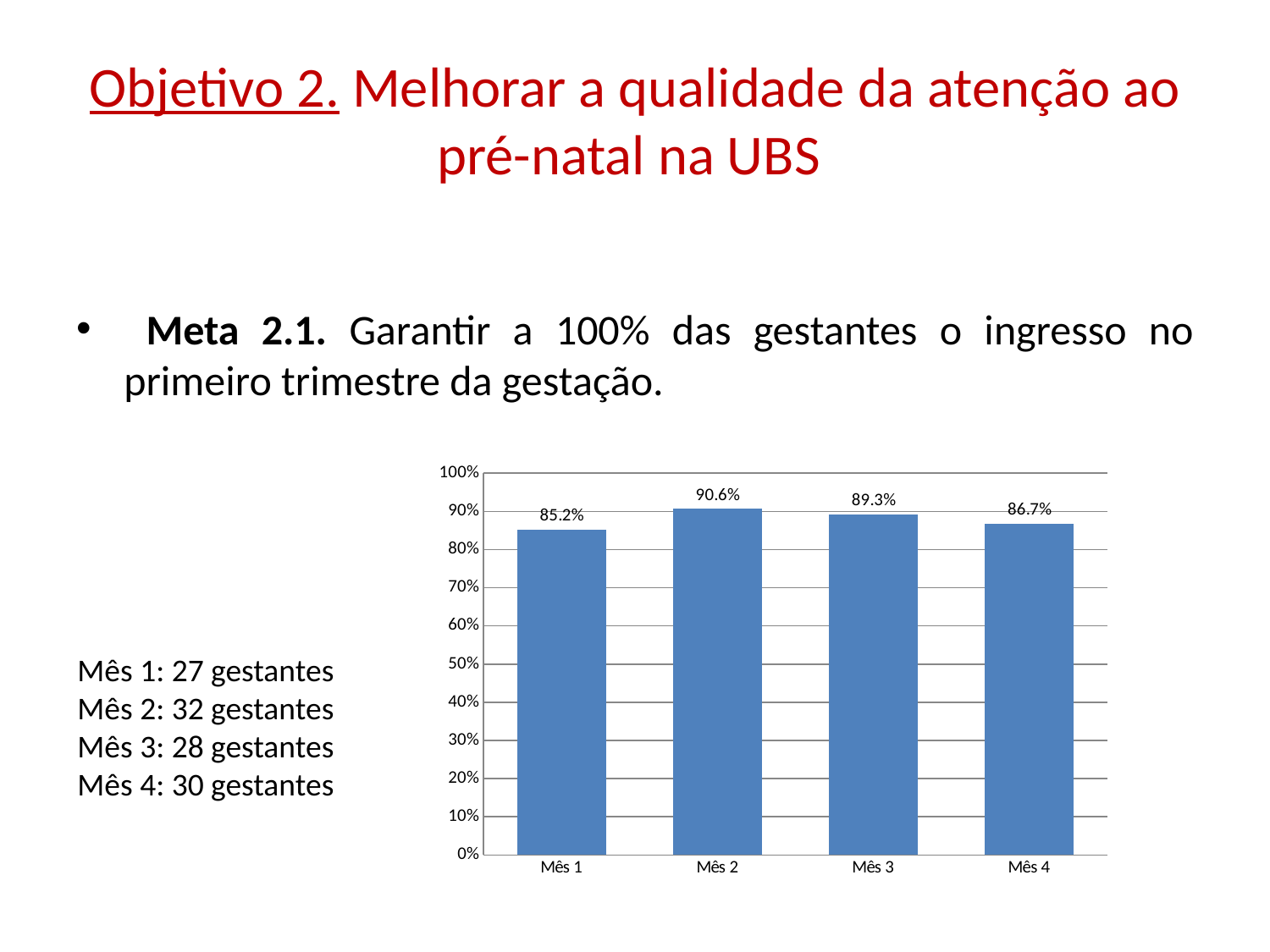
What is the value for Mês 1? 85.2% What is the value for Mês 4? 86.7% What is the difference between the values for Mês 2 and Mês 1? 5.4% Is the value for Mês 2 greater or less than 90%? greater Which month has the highest value? Mês 2 How many categories are shown on the x axis? 4 What is the difference between the values for Mês 3 and Mês 4? 2.6% What is the value for Mês 2? 90.6% Which is larger, the value for Mês 3 or the value for Mês 4? Mês 3 Which month has the lowest value? Mês 1 What is the value for Mês 3? 89.3% What kind of chart is shown on the slide? bar chart